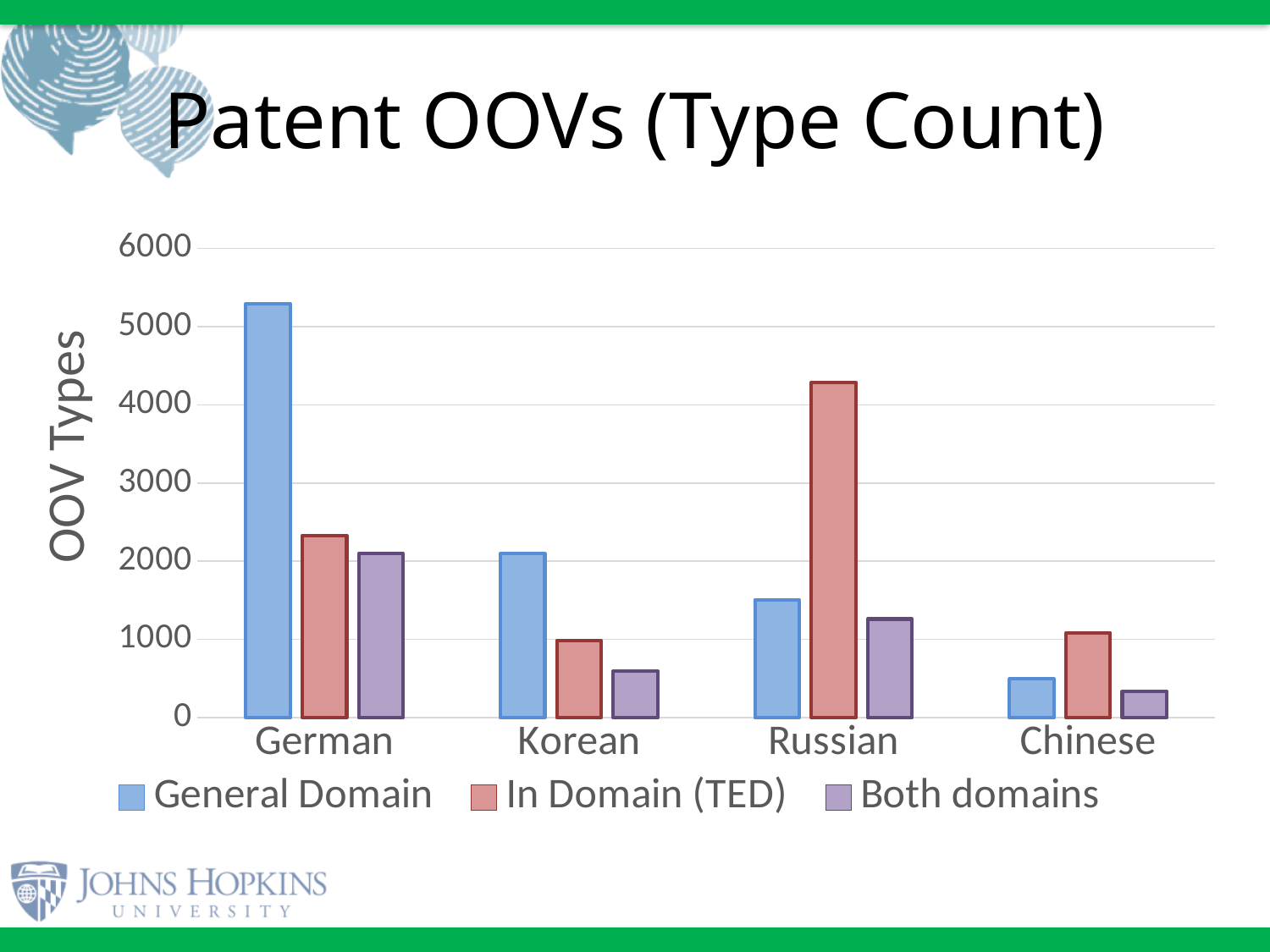
Which language has the highest In Domain (TED) value? Russian What kind of chart is shown on the slide? bar chart What is the title of the chart? Patent OOVs (Type Count) How many languages are shown on the x axis of the chart? 4 How many series does the legend list? 3 Which language has the lowest Both domains value? Chinese Is the General Domain value for German greater or less than 5000? greater Is the General Domain value for Russian greater or less than 1000? greater What is the label on the vertical axis? OOV Types For Korean, which is larger: the General Domain value or the In Domain (TED) value? General Domain Is the Both domains value for Korean greater or less than 1000? less Which language has the highest General Domain value? German